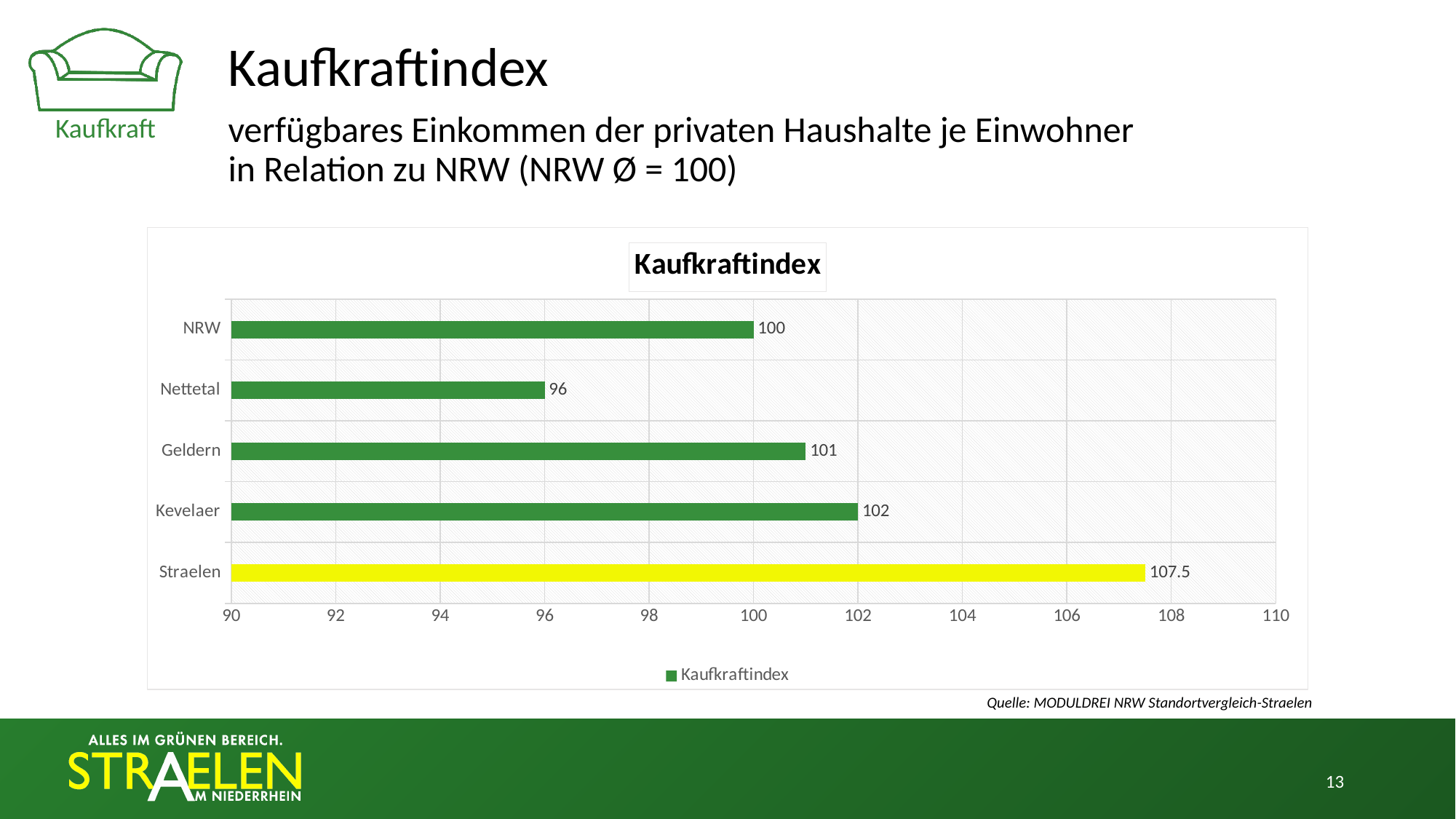
What is the Kaufkraftindex value for Nettetal? 96 Which category has the lowest Kaufkraftindex? Nettetal What kind of chart is shown on the slide? Bar chart How many categories are shown in the chart? 5 Which has a higher Kaufkraftindex, Geldern or Kevelaer? Kevelaer Which category has the highest Kaufkraftindex? Straelen What is the Kaufkraftindex value for Geldern? 101 Which bar in the chart is coloured yellow instead of green? Straelen What is the Kaufkraftindex value for Kevelaer? 102 What is the difference between the Kaufkraftindex of Straelen and NRW? 7.5 What is the difference between the Kaufkraftindex of Kevelaer and Nettetal? 6 What is the Kaufkraftindex value for Straelen? 107.5